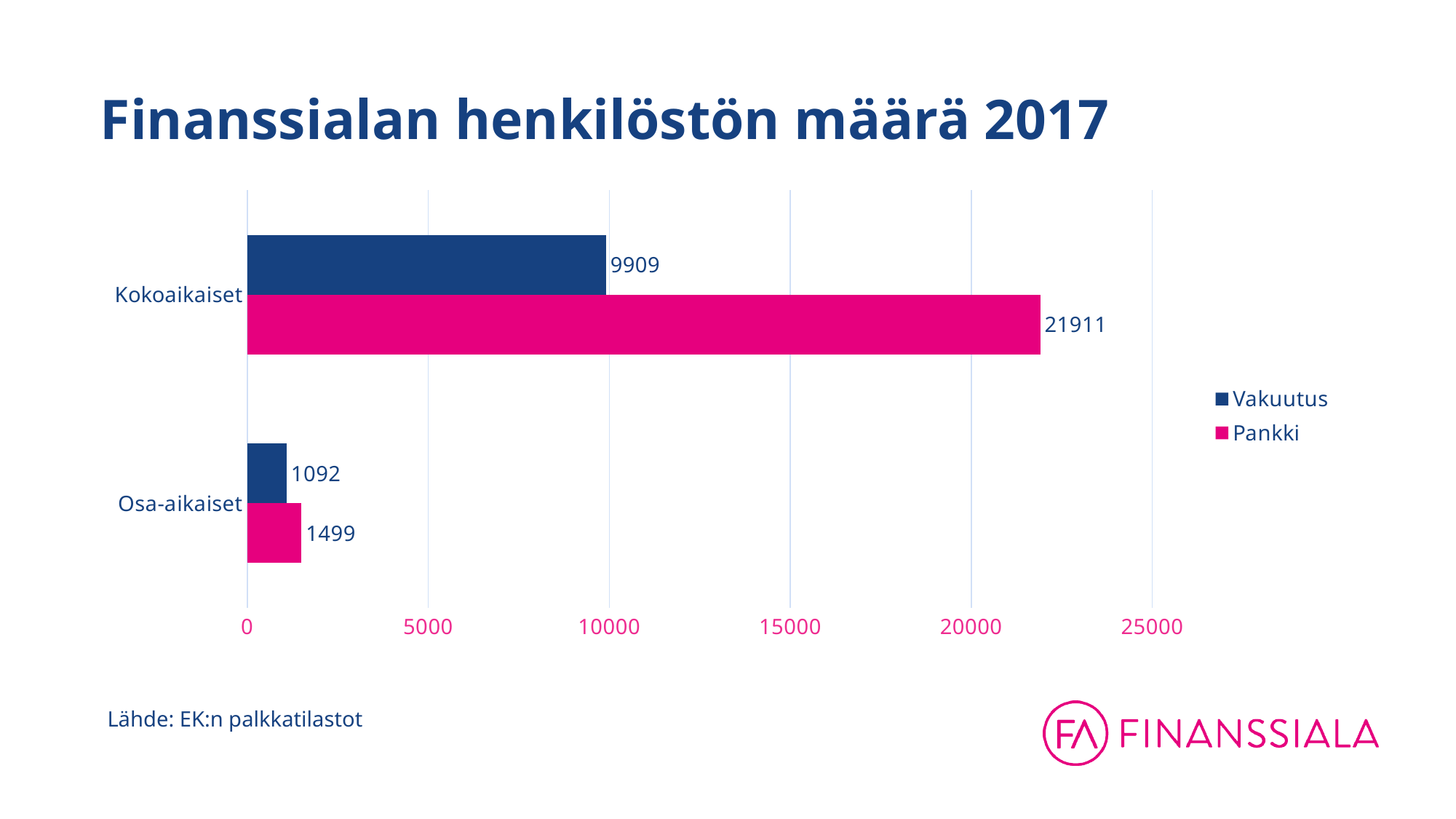
What is the value for Pankki in the Kokoaikaiset category? 21911 Which bar has the highest value on the chart? Pankki, Kokoaikaiset What is the difference between the Pankki and Vakuutus values for Osa-aikaiset? 407 What kind of chart is shown on the slide? Bar chart What is the value for Vakuutus in the Kokoaikaiset category? 9909 How many series does the legend list? 2 What is the difference between the Pankki and Vakuutus values for Kokoaikaiset? 12002 How many categories are shown on the chart? 2 Which bar has the lowest value on the chart? Vakuutus, Osa-aikaiset Which is larger for Osa-aikaiset: Vakuutus or Pankki? Pankki What is the value for Pankki in the Osa-aikaiset category? 1499 What is the value for Vakuutus in the Osa-aikaiset category? 1092